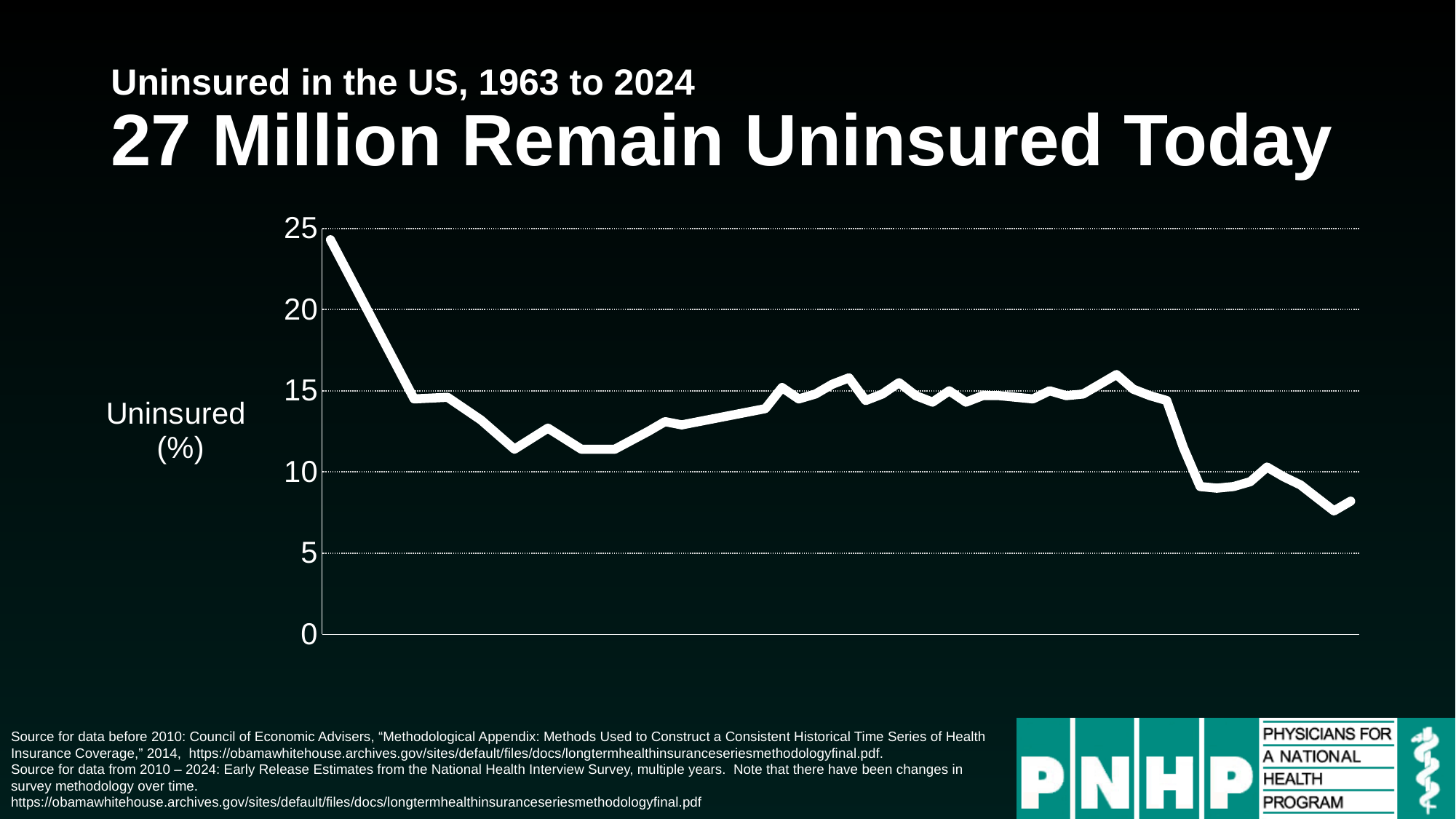
Is the lowest point on the line greater or less than 10? less What is the title of the chart on the slide? Uninsured in the US, 1963 to 2024 Is the highest point on the line greater or less than 20? greater What is the highest tick value shown on the vertical axis? 25 Overall, does the uninsured percentage rise or fall from the left end of the chart to the right end? fall What kind of chart is shown on the slide? line chart Is the value at the rightmost point of the line greater or less than 10? less Which is larger, the value at the leftmost point of the line or the value at the rightmost point? the leftmost point Where along the x axis does the line reach its highest value: at the left end, in the middle, or at the right end? at the left end What is the label on the vertical axis of the chart? Uninsured (%)